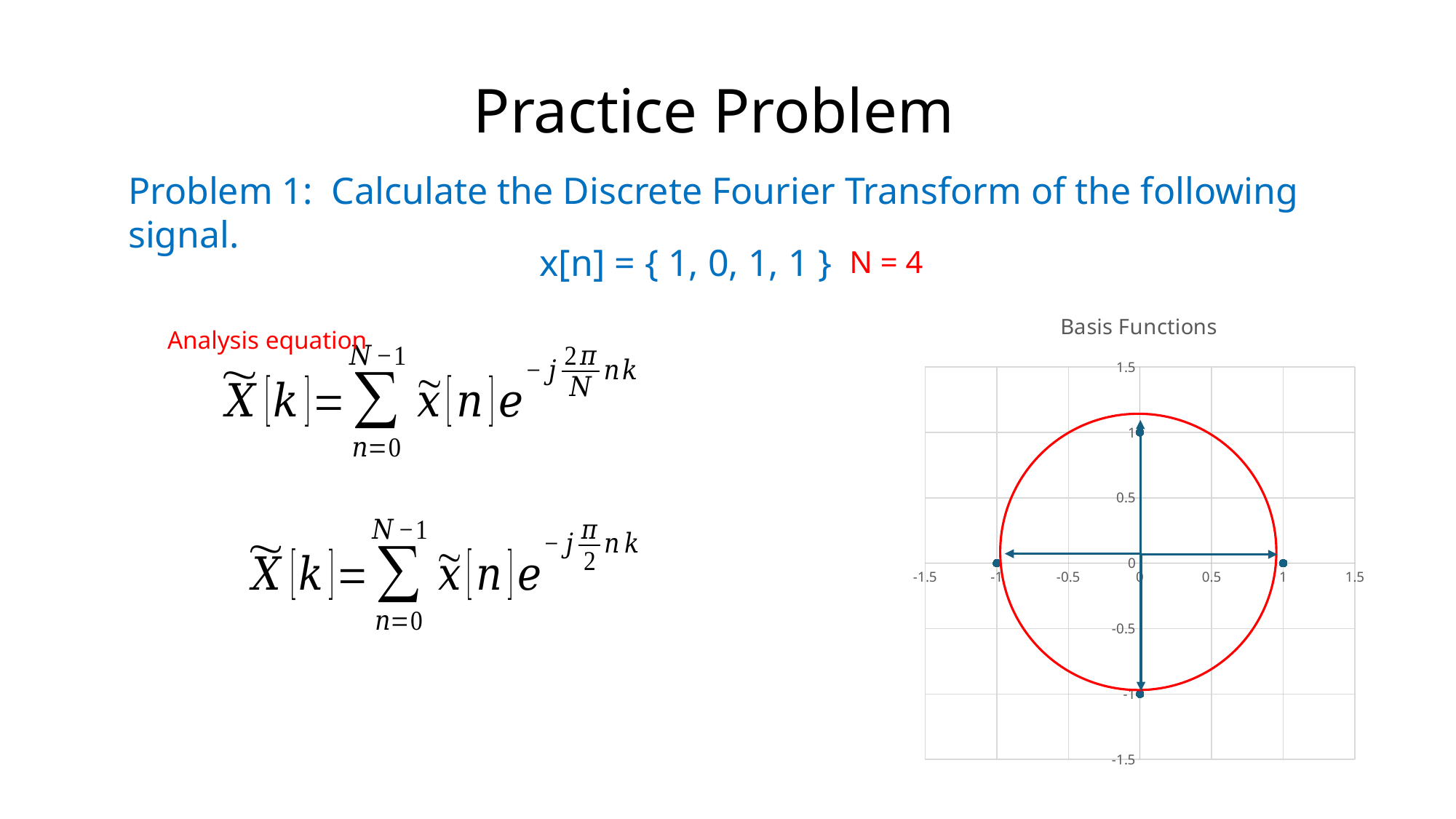
On the "Basis Functions" chart, what is the highest y value among the plotted points? 1 What kind of chart is the "Basis Functions" chart? scatter chart On the "Basis Functions" chart, what is the difference between the x value of the rightmost point and the x value of the leftmost point? 2 What colour is the circle drawn on the "Basis Functions" chart? red On the "Basis Functions" chart, which point has the larger x value: the rightmost point or the leftmost point? the rightmost point On the "Basis Functions" chart, is the x value of the rightmost point greater or less than 0.5? greater On the "Basis Functions" chart, what is the lowest x value among the plotted points? -1 On the "Basis Functions" chart, what is the y value of the point lying on the negative y axis? -1 On the "Basis Functions" chart, what is the x value of the point lying on the positive x axis? 1 What is the title of the chart on the slide? Basis Functions How many data points are plotted on the "Basis Functions" chart? 4